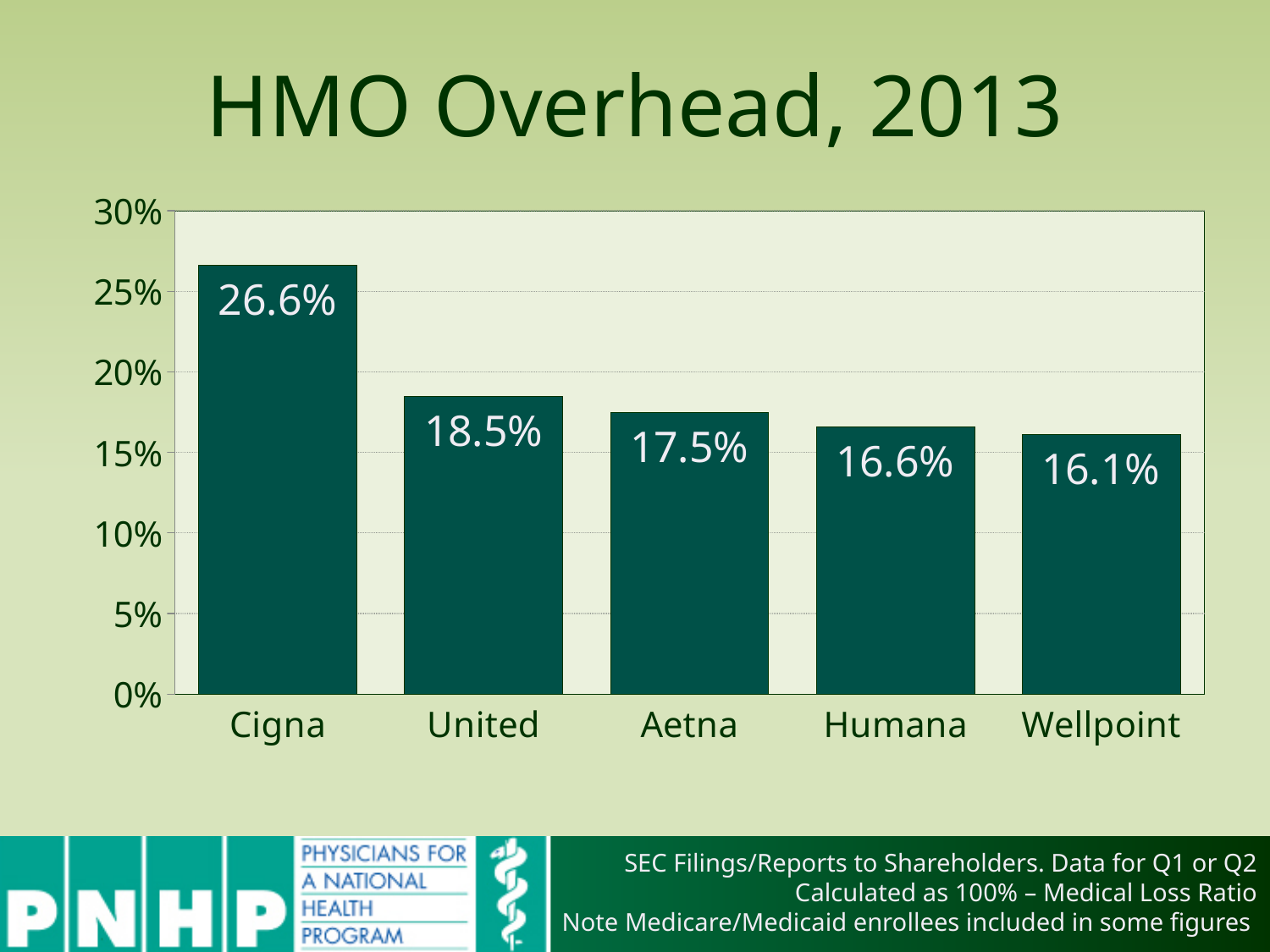
What is the overhead value for Humana? 16.6% What is the difference between Cigna's and United's overhead? 8.1% Is the value for Cigna greater or less than 25%? greater What is the difference between Aetna's and Humana's overhead? 0.9% Which has a higher overhead, United or Aetna? United How many HMOs are shown in the chart? 5 Which HMO has the highest overhead? Cigna What is the title of the chart? HMO Overhead, 2013 What is the overhead value for Wellpoint? 16.1% Which HMO has the lowest overhead? Wellpoint What kind of chart is shown on the slide? Bar chart What is the overhead value for Cigna? 26.6%